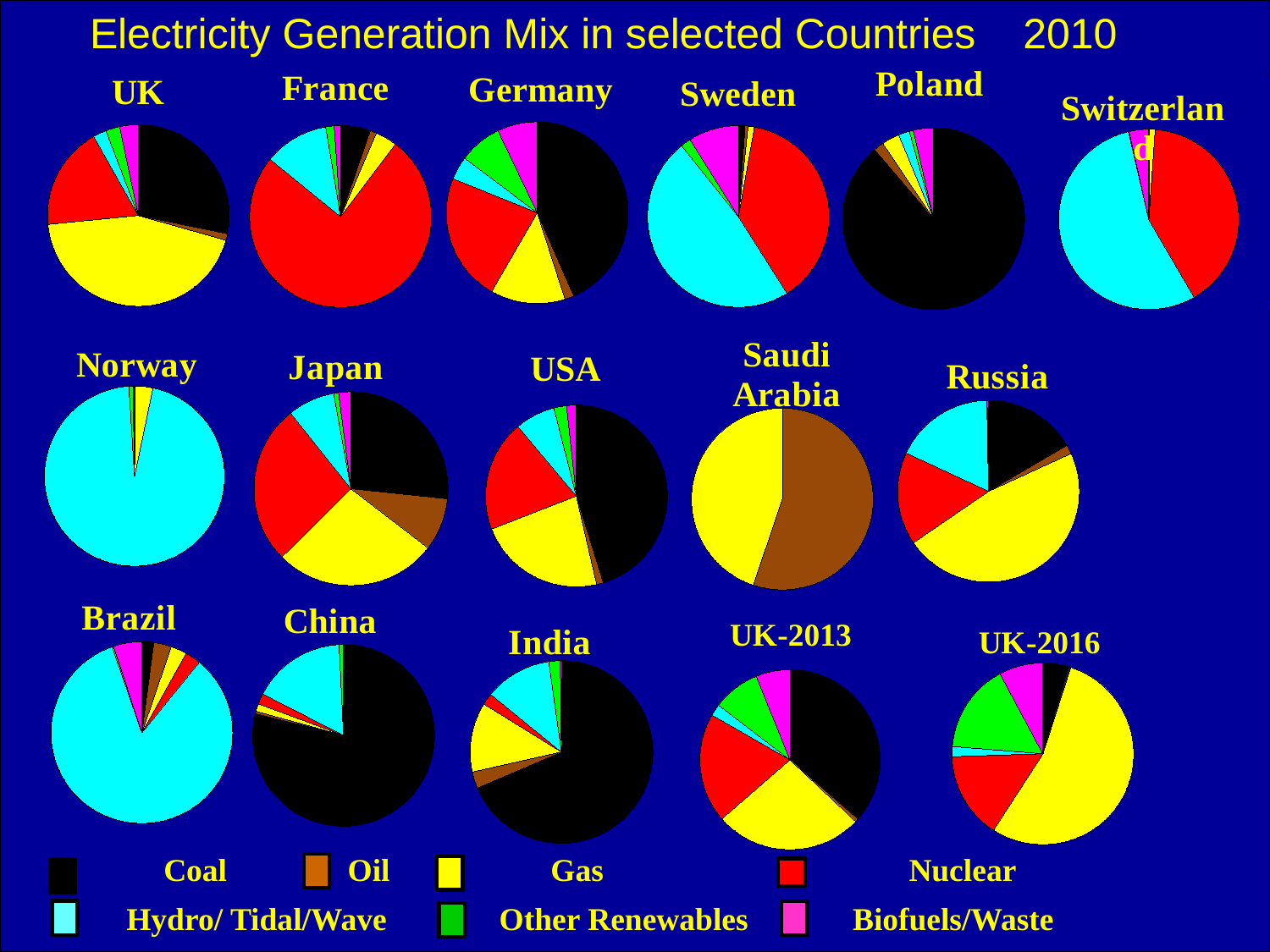
How many energy sources does the legend at the bottom of the slide list? 7 In the Norway pie chart, which energy source has the largest slice? Hydro/ Tidal/Wave In the UK-2016 pie chart, which energy source has the largest slice? Gas What kind of chart is used to show each country's electricity generation mix on the slide? Pie chart In the Brazil pie chart, which energy source has the largest slice? Hydro/ Tidal/Wave How many pie charts are shown on the slide? 16 In the UK pie chart (2010), which slice is larger, Gas or Coal? Gas According to the legend, which colour represents Nuclear? Red